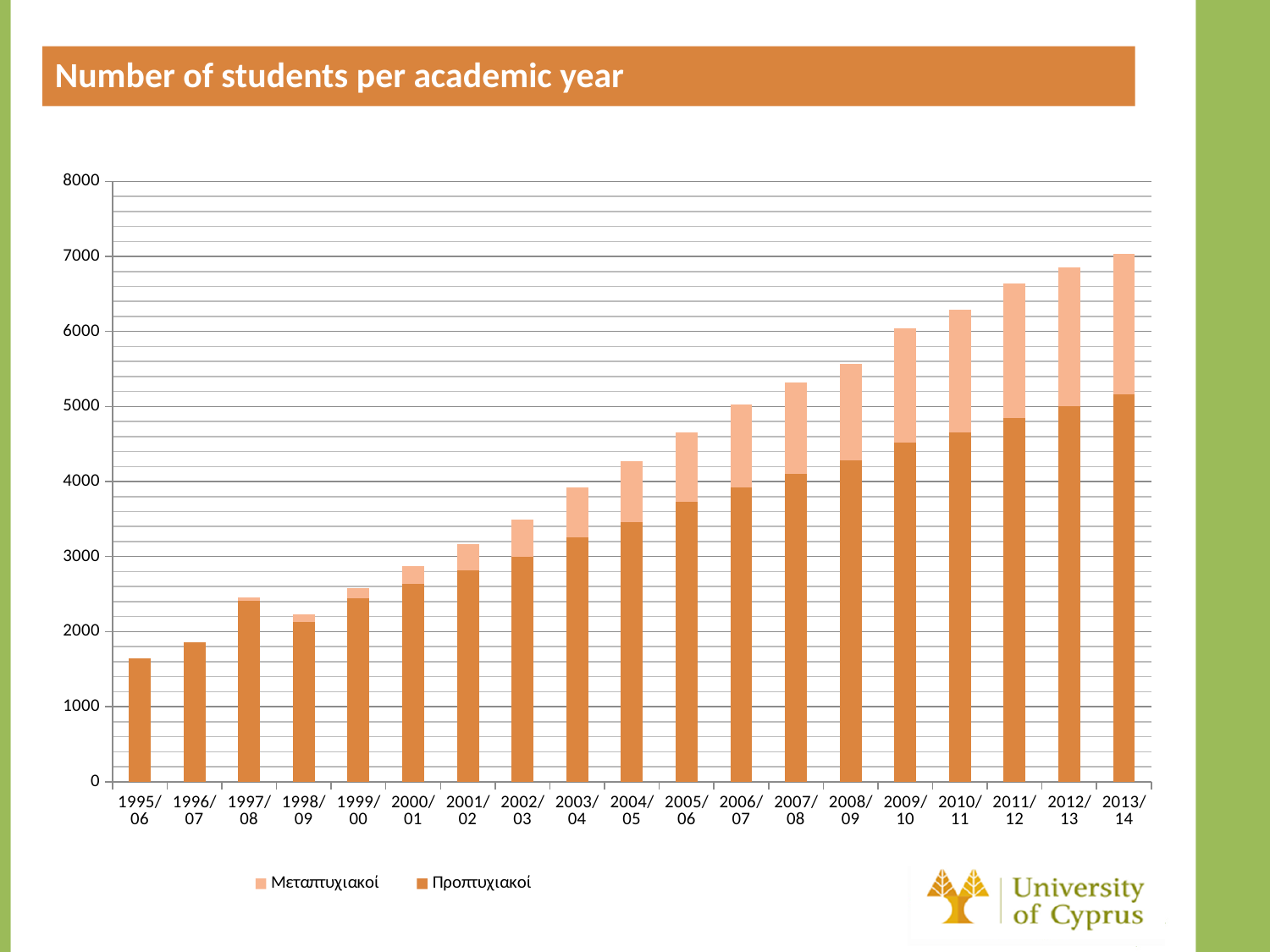
Is the total number of students in 2008/09 greater or less than 5000? greater In 2013/14, which series has the larger value, Μεταπτυχιακοί or Προπτυχιακοί? Προπτυχιακοί Do the total numbers of students generally rise or fall from 1995/06 to 2013/14? Rise How many academic years are shown on the x axis of the chart? 19 Which academic year has the lowest total number of students? 1995/06 What kind of chart is shown on the slide? Stacked bar chart What is the title of the chart? Number of students per academic year How many series does the chart's legend list? 2 Is the number of Προπτυχιακοί students in 2013/14 greater or less than 5000? greater Is the total number of students in 1995/06 greater or less than 2000? less Which academic year has the highest total number of students? 2013/14 Which series is shown in the darker orange colour in the chart? Προπτυχιακοί